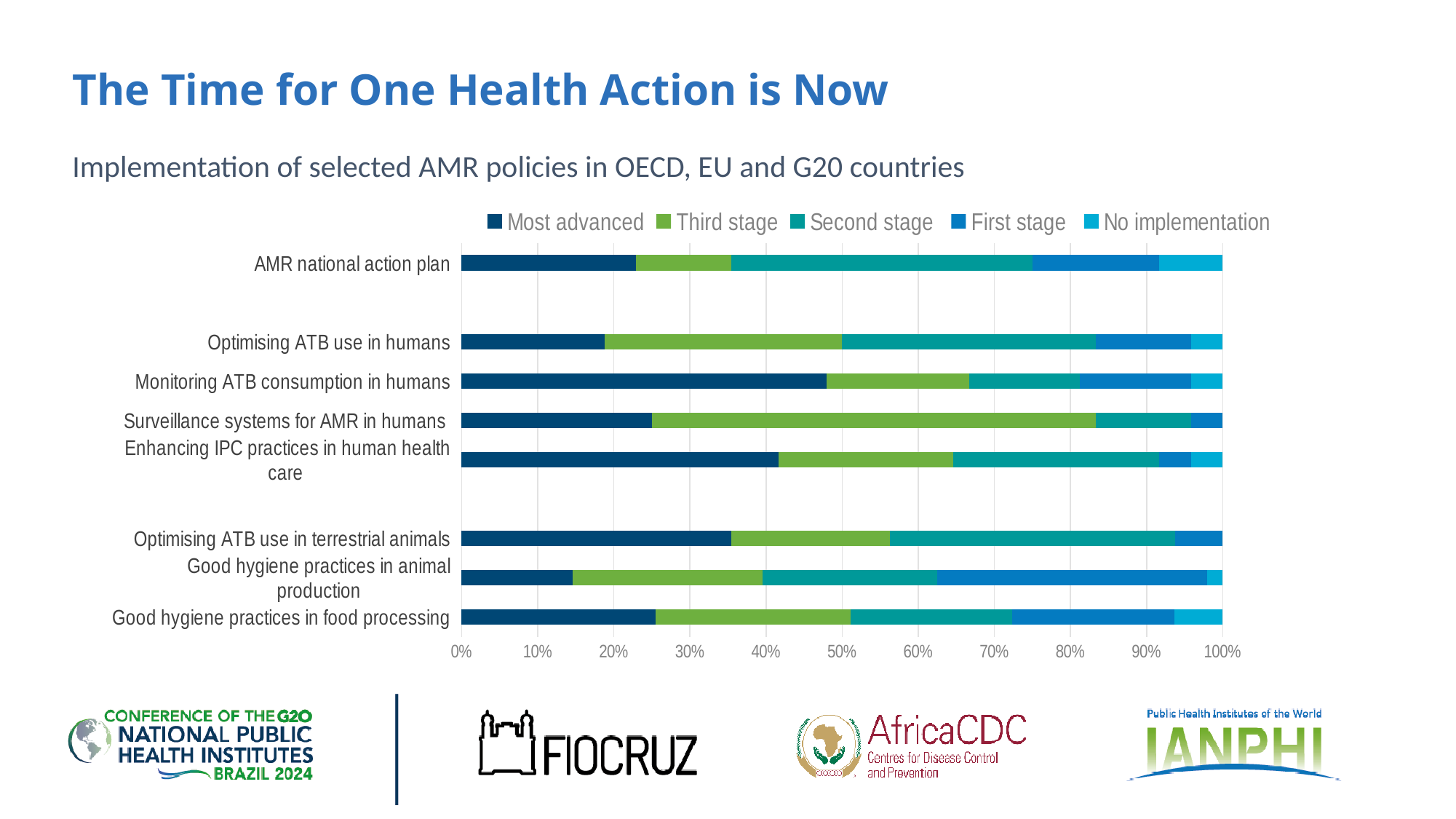
What kind of chart is shown on the slide? Stacked bar chart How many policy categories are plotted on the chart? 8 Is the 'Most advanced' share for AMR national action plan greater or less than 30%? less Which policy has the largest 'Third stage' share? Surveillance systems for AMR in humans Which policy has the largest 'Most advanced' share? Monitoring ATB consumption in humans How many series does the legend list? 5 Which policy has the smallest 'Most advanced' share? Good hygiene practices in animal production Which legend entry is shown in the lightest blue colour? No implementation Is the 'Most advanced' share for Monitoring ATB consumption in humans greater or less than 40%? greater Is the 'Most advanced' share for Good hygiene practices in animal production greater or less than 20%? less Which has the larger 'Most advanced' share: Optimising ATB use in terrestrial animals or Good hygiene practices in food processing? Optimising ATB use in terrestrial animals What is the title of the chart? Implementation of selected AMR policies in OECD, EU and G20 countries